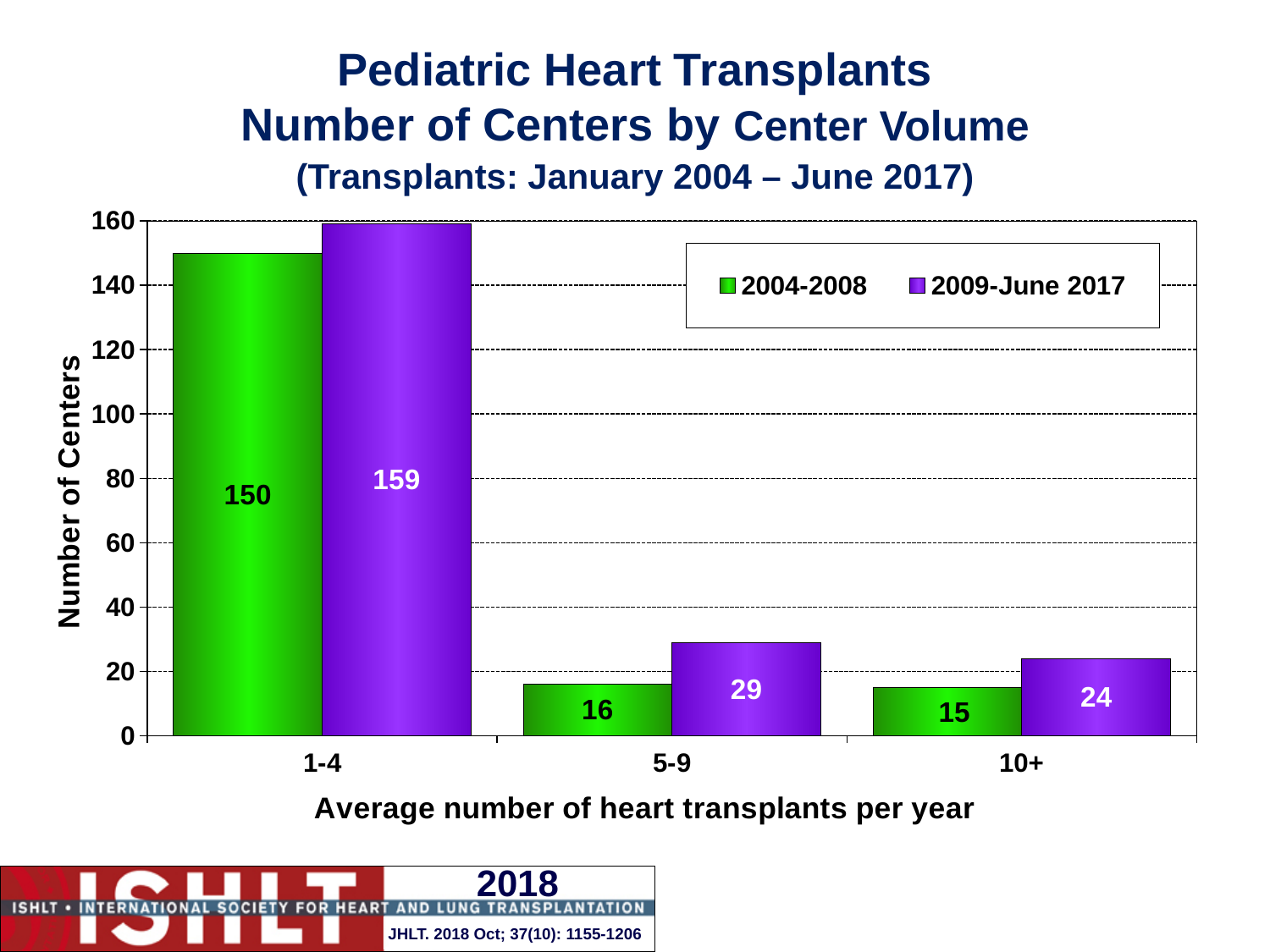
How many centers averaged 1-4 heart transplants per year in 2004-2008? 150 How many centers averaged 5-9 heart transplants per year in 2009-June 2017? 29 Which center volume category has the lowest number of centers for 2004-2008? 10+ How many center volume categories are shown on the x axis? 3 What kind of chart is shown on the slide? Bar chart How many series does the legend list? 2 Which center volume category has the highest number of centers for 2009-June 2017? 1-4 What is the difference between the 2009-June 2017 and 2004-2008 values for the 5-9 category? 13 What is the number of centers in the 10+ category for 2004-2008? 15 What is the difference between the 2009-June 2017 and 2004-2008 values for the 1-4 category? 9 Which is larger for the 10+ category: the 2004-2008 value or the 2009-June 2017 value? 2009-June 2017 What is the label of the y axis? Number of Centers